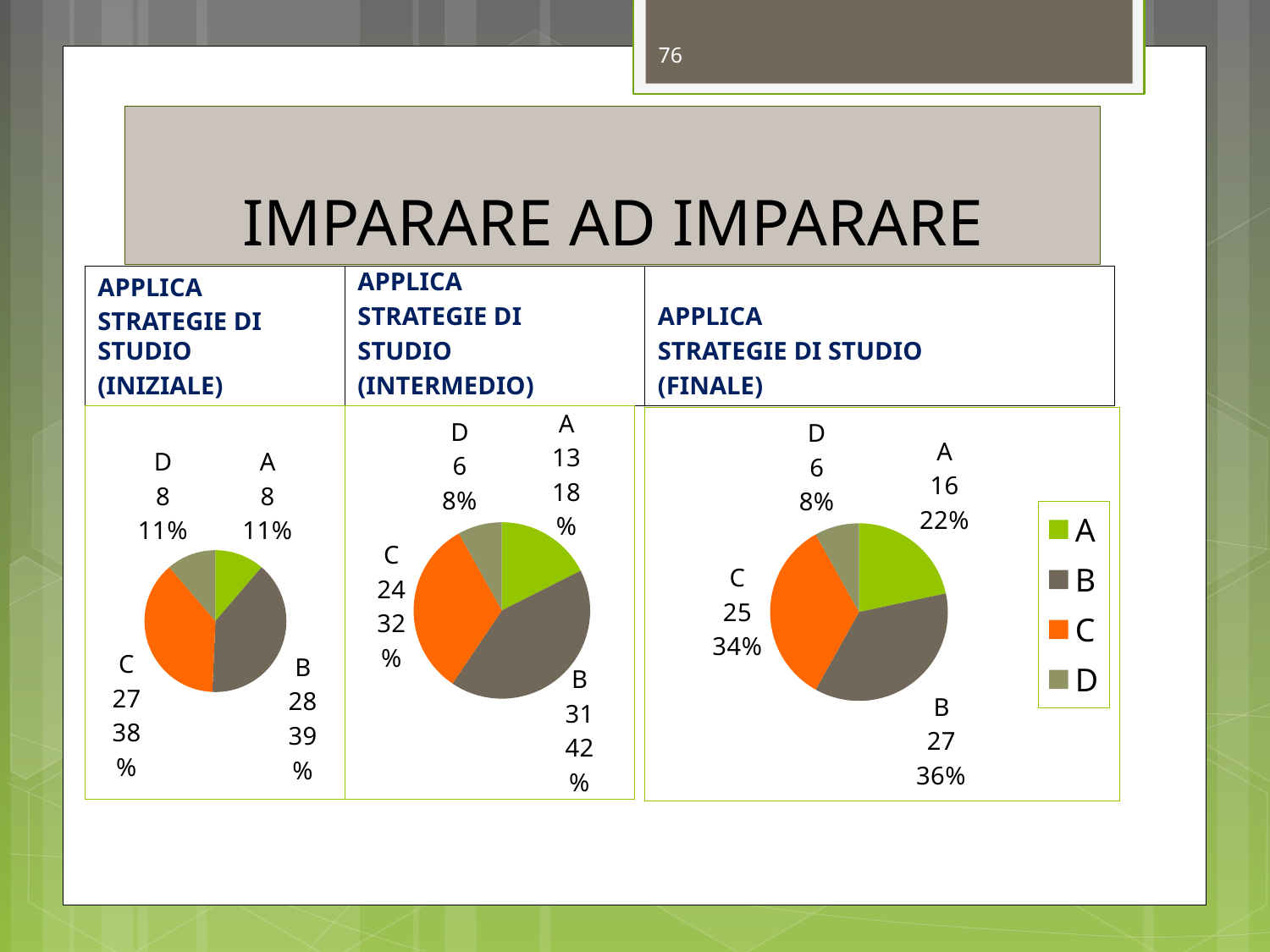
In the legend next to the APPLICA STRATEGIE DI STUDIO (FINALE) chart, which category is shown in orange? C In the APPLICA STRATEGIE DI STUDIO (FINALE) chart, what percentage share does category A have? 22% In the APPLICA STRATEGIE DI STUDIO (FINALE) chart, which is larger, the value for B or the value for A? B In the APPLICA STRATEGIE DI STUDIO (INTERMEDIO) chart, which category has the largest slice? B In the APPLICA STRATEGIE DI STUDIO (FINALE) chart, what is the difference between the values for B and C? 2 In the APPLICA STRATEGIE DI STUDIO (INTERMEDIO) chart, what is the value for category A? 13 In the APPLICA STRATEGIE DI STUDIO (INTERMEDIO) chart, which category has the smallest slice? D In the APPLICA STRATEGIE DI STUDIO (INIZIALE) chart, what is the value for category C? 27 How many categories does the APPLICA STRATEGIE DI STUDIO (INIZIALE) chart show? 4 In the APPLICA STRATEGIE DI STUDIO (FINALE) chart, what is the value for category D? 6 What kind of chart is used for APPLICA STRATEGIE DI STUDIO (FINALE)? Pie chart In the APPLICA STRATEGIE DI STUDIO (INIZIALE) chart, what percentage share does category B have? 39%